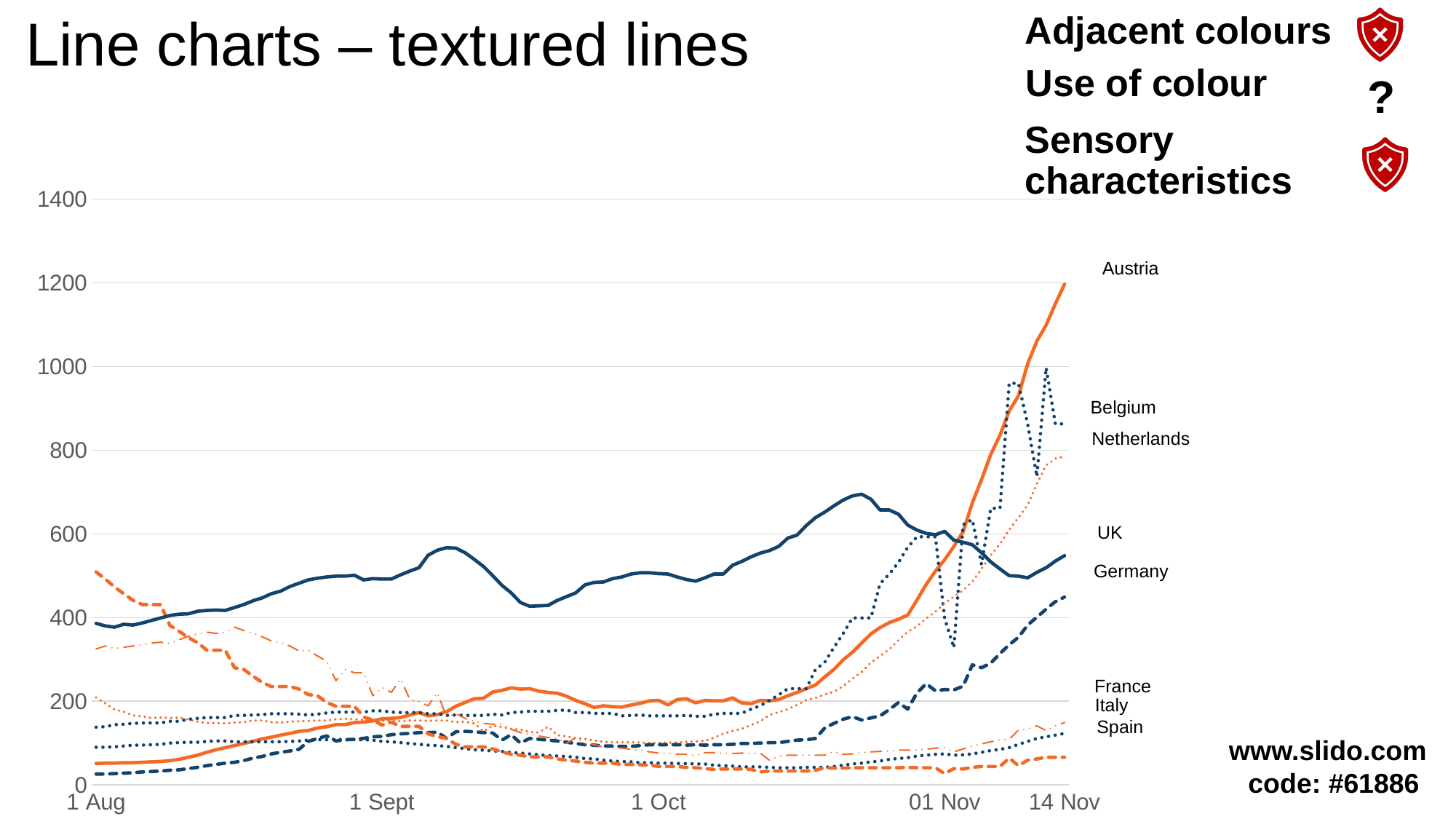
Does the Austria line rise or fall between 1 Oct and 14 Nov? rise What kind of chart is shown on the slide? line chart Does the France line rise or fall between 1 Aug and 1 Sept? fall Is the value for Germany at 14 Nov greater or less than 400? greater How many countries are labelled on the chart? 8 Which country has the highest value at 14 Nov? Austria What is the highest value shown on the y axis? 1400 At 14 Nov, which is larger, the value for Austria or the value for UK? Austria Is the value for UK at 14 Nov greater or less than 600? less Is the value for Austria at 14 Nov greater or less than 1000? greater What is the title of the slide? Line charts – textured lines